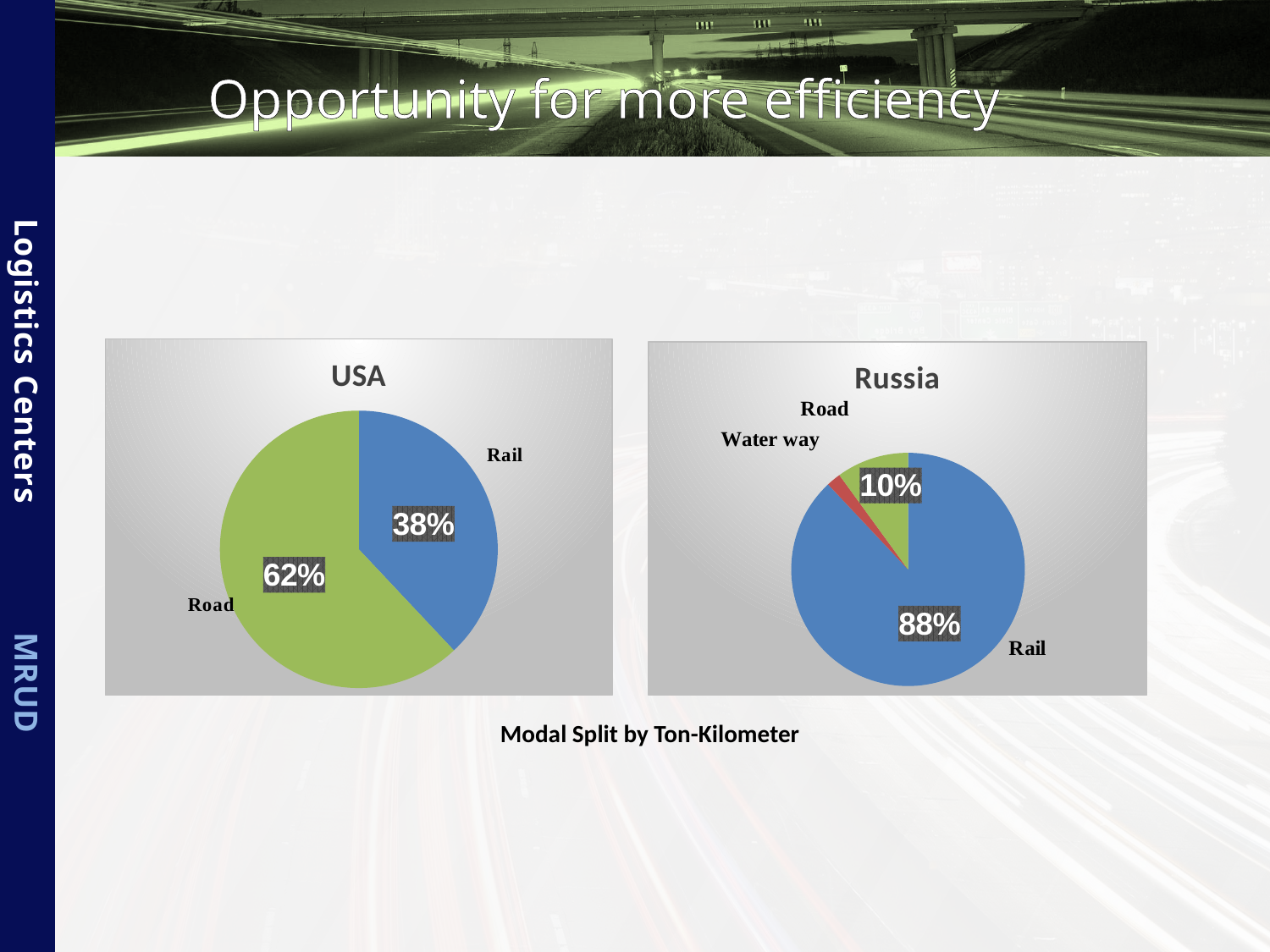
In the USA chart, what share does Rail have? 38% In the Russia chart, what is the difference in percentage points between Rail and Road? 78 In the Russia chart, which mode has the largest share? Rail In the Russia chart, what share does Rail have? 88% What type of chart is the USA chart? Pie chart Which is larger: the Rail share in the USA chart or the Rail share in the Russia chart? Russia In the Russia chart, which mode has the smallest share? Water way How many slices does the Russia pie chart have? 3 In the Russia chart, what share does Road have? 10% In the USA chart, what share does Road have? 62% In the USA chart, what is the difference in percentage points between Road and Rail? 24 In the USA chart, which mode has the largest share? Road